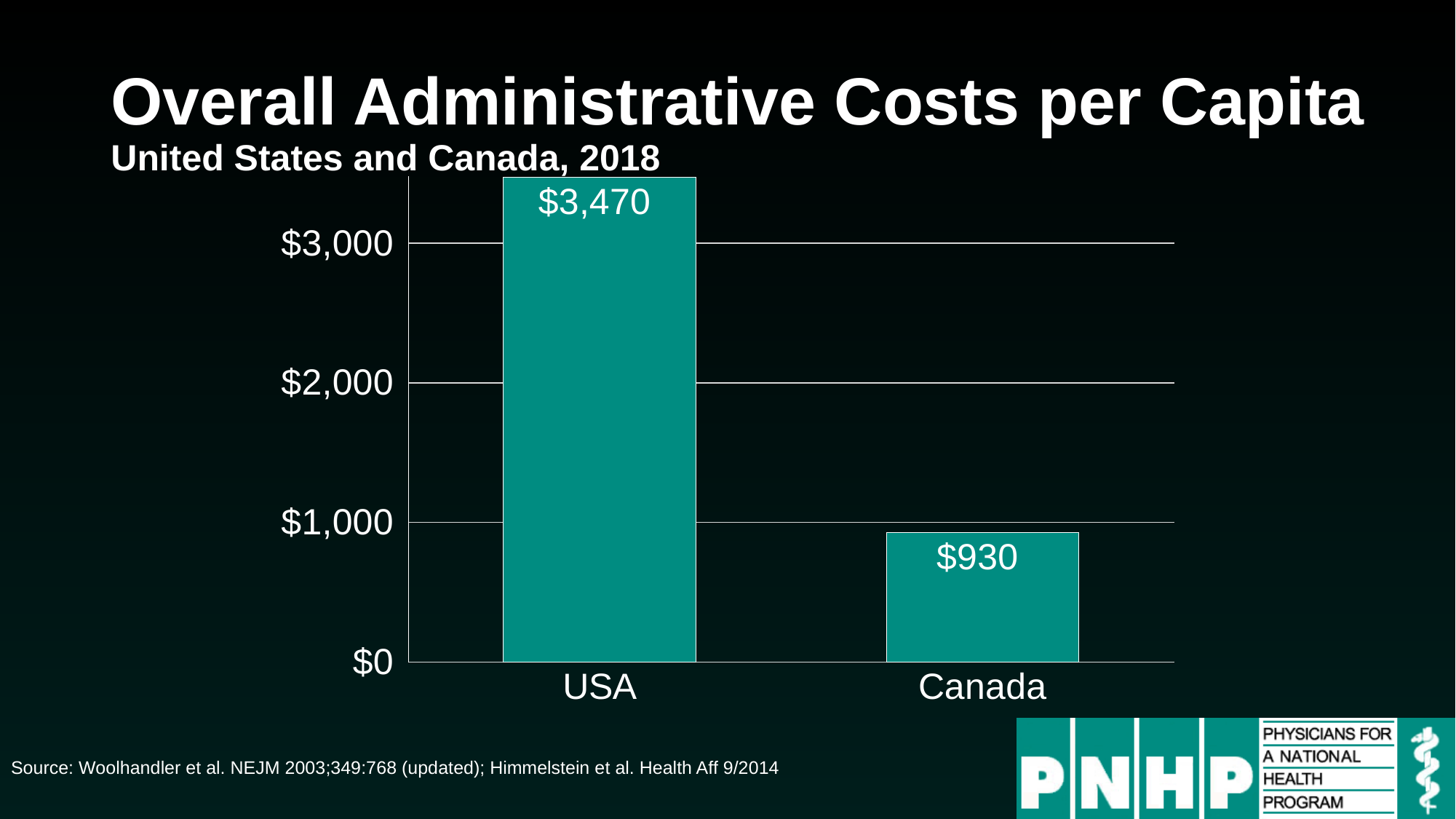
What year does the chart's data refer to? 2018 Which country has the higher administrative cost per capita? USA Is the administrative cost per capita larger for the USA or for Canada? USA What is the difference between the USA and Canada administrative costs per capita? $2,540 Which country has the lower administrative cost per capita? Canada How many countries are shown in the chart? 2 What is the overall administrative cost per capita for Canada? $930 What is the overall administrative cost per capita for the USA? $3,470 What is the title of the chart? Overall Administrative Costs per Capita What type of chart is shown on the slide? bar chart Is the value for the USA greater or less than $3,000? greater Is the value for Canada greater or less than $1,000? less